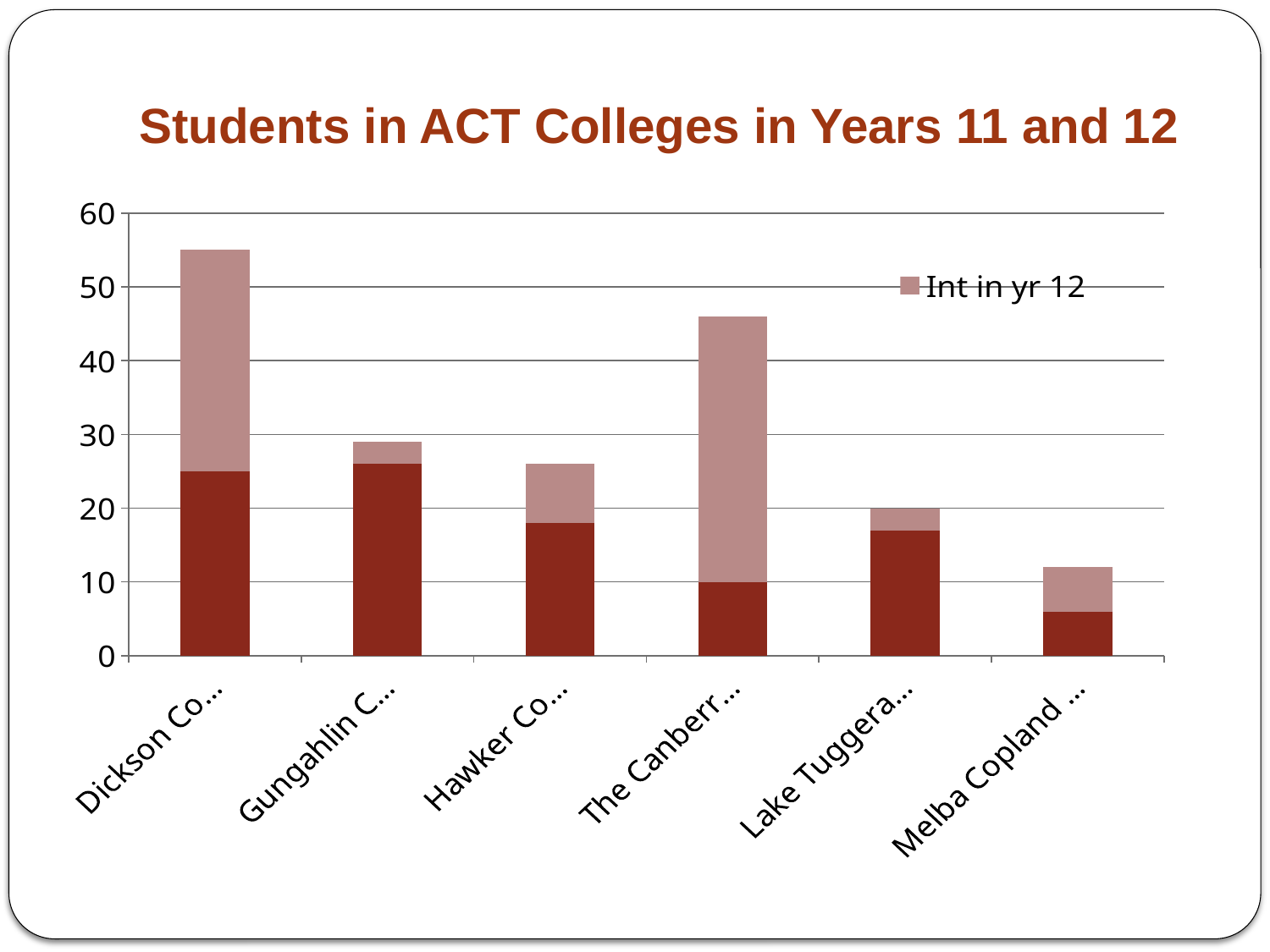
What series name is shown in the chart legend? Int in yr 12 Is the total bar height for Gungahlin C... greater or less than 20? greater What kind of chart is shown on the slide? stacked bar chart Which college has the tallest stacked bar overall? Dickson Co... How many colleges (categories) are plotted on the x axis? 6 Is the total bar height for The Canberr... greater or less than 40? greater Which has the taller total bar, Hawker Co... or Lake Tuggera...? Hawker Co... Which has the taller total bar, Dickson Co... or The Canberr...? Dickson Co... What is the total height of the stacked bar for Lake Tuggera...? 20 Which college has the shortest stacked bar overall? Melba Copland ... Which college has the largest 'Int in yr 12' (lighter) segment? The Canberr... Is the total bar height for Dickson Co... greater or less than 50? greater